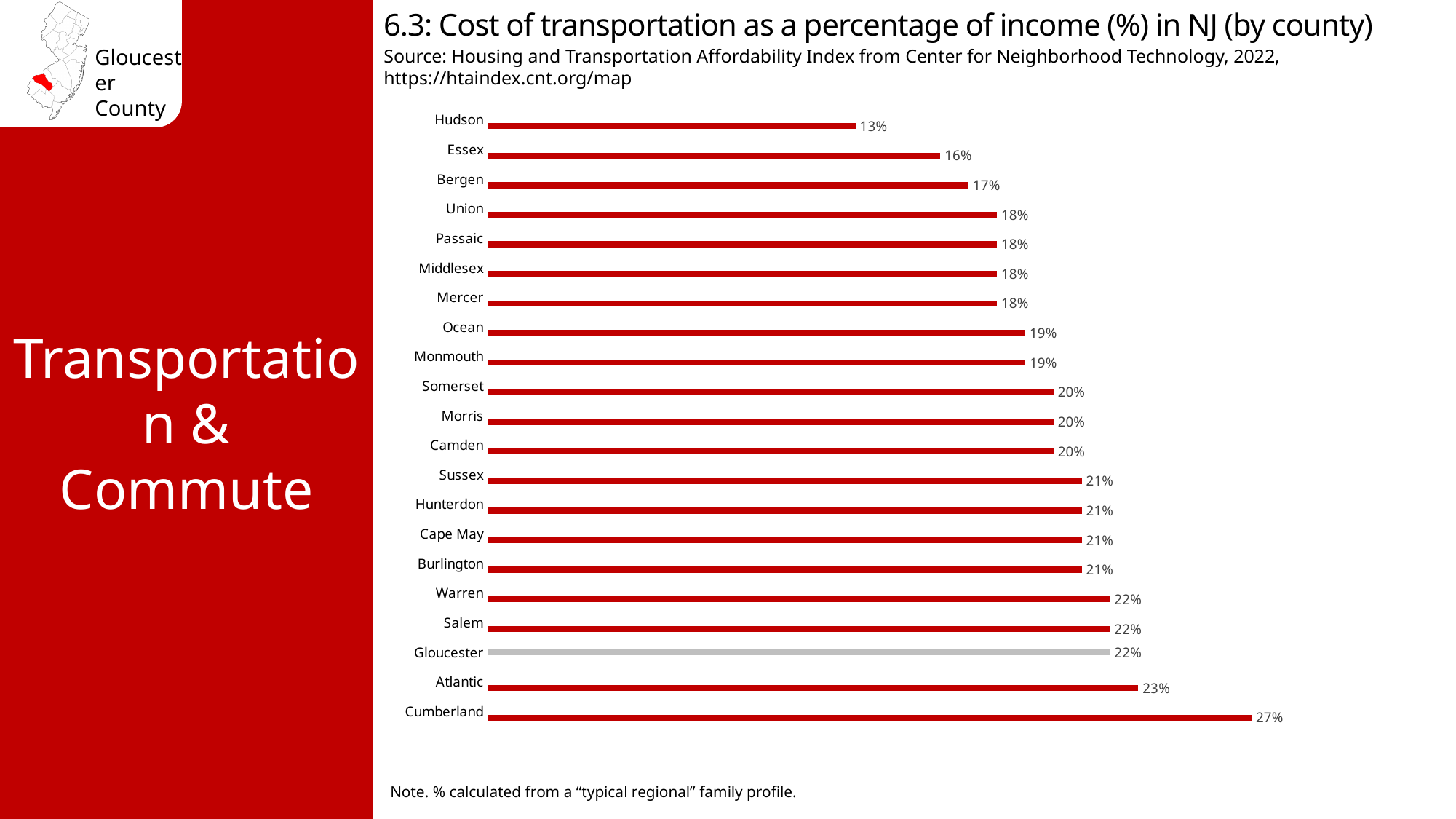
What is the difference between the values for Gloucester and Essex? 6% What is the value shown for Hudson County? 13% Which has a higher value, Bergen or Camden? Camden What type of chart is shown on the slide? Bar chart What is the value shown for Atlantic County? 23% Which county's bar is shown in gray instead of red? Gloucester What is the value shown for Cumberland County? 27% What is the cost of transportation as a percentage of income for Gloucester County? 22% How many counties are shown in the chart? 21 What is the difference between the values for Cumberland and Hudson? 14% Which county has the lowest cost of transportation as a percentage of income? Hudson Which county has the highest cost of transportation as a percentage of income? Cumberland